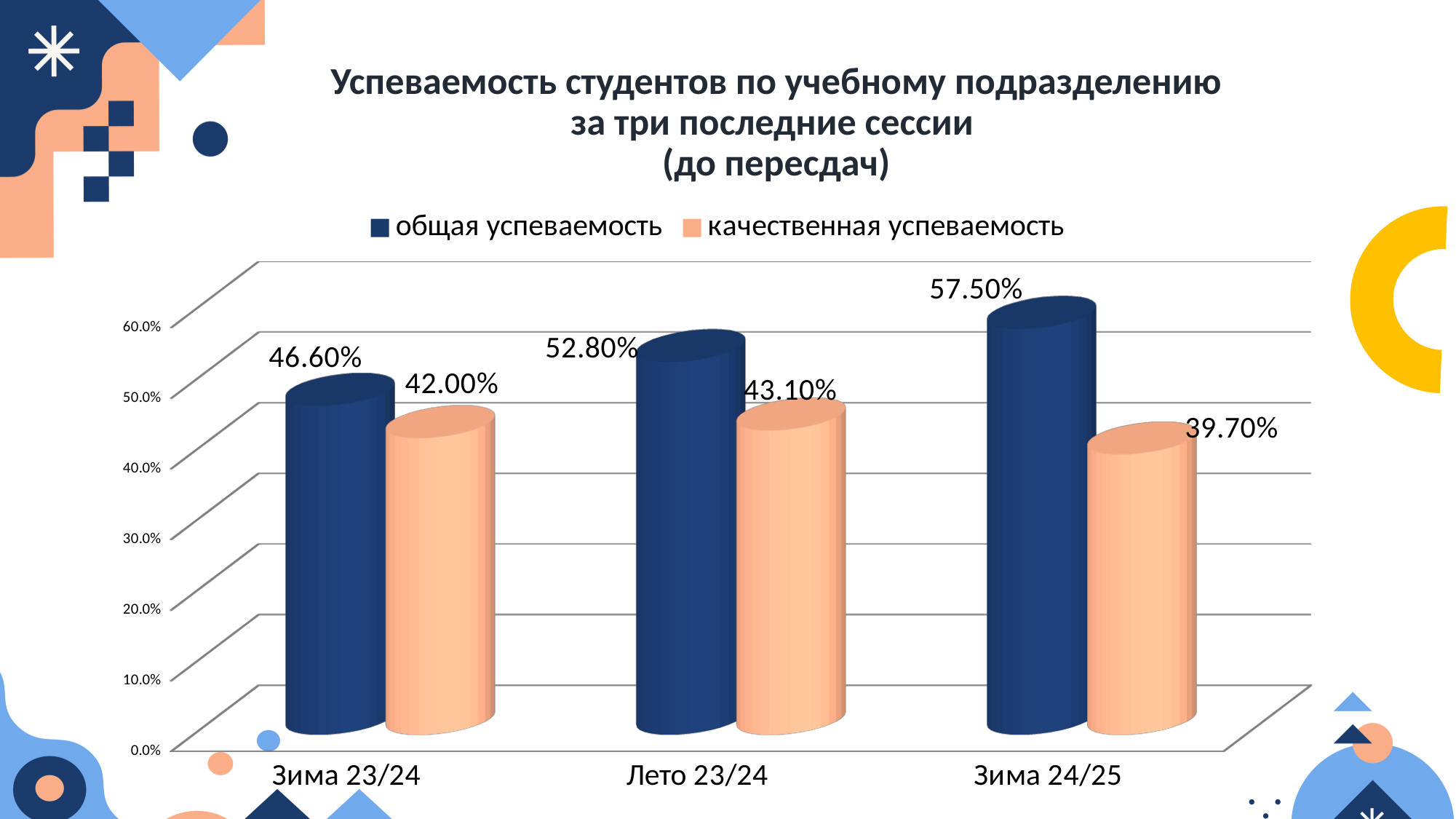
How many series does the legend list? 2 What kind of chart is shown on the slide? Bar chart What is the value of качественная успеваемость for Зима 24/25? 39.70% Does общая успеваемость rise or fall across the three sessions from Зима 23/24 to Зима 24/25? Rises What is the value of общая успеваемость for Зима 24/25? 57.50% Which is larger: качественная успеваемость for Зима 23/24 or for Лето 23/24? Лето 23/24 What is the value of общая успеваемость for Зима 23/24? 46.60% Which session has the highest общая успеваемость? Зима 24/25 How many sessions (categories) are shown on the x axis? 3 What is the difference between общая успеваемость and качественная успеваемость for Зима 24/25? 17.80% Which session has the lowest качественная успеваемость? Зима 24/25 What is the value of качественная успеваемость for Лето 23/24? 43.10%